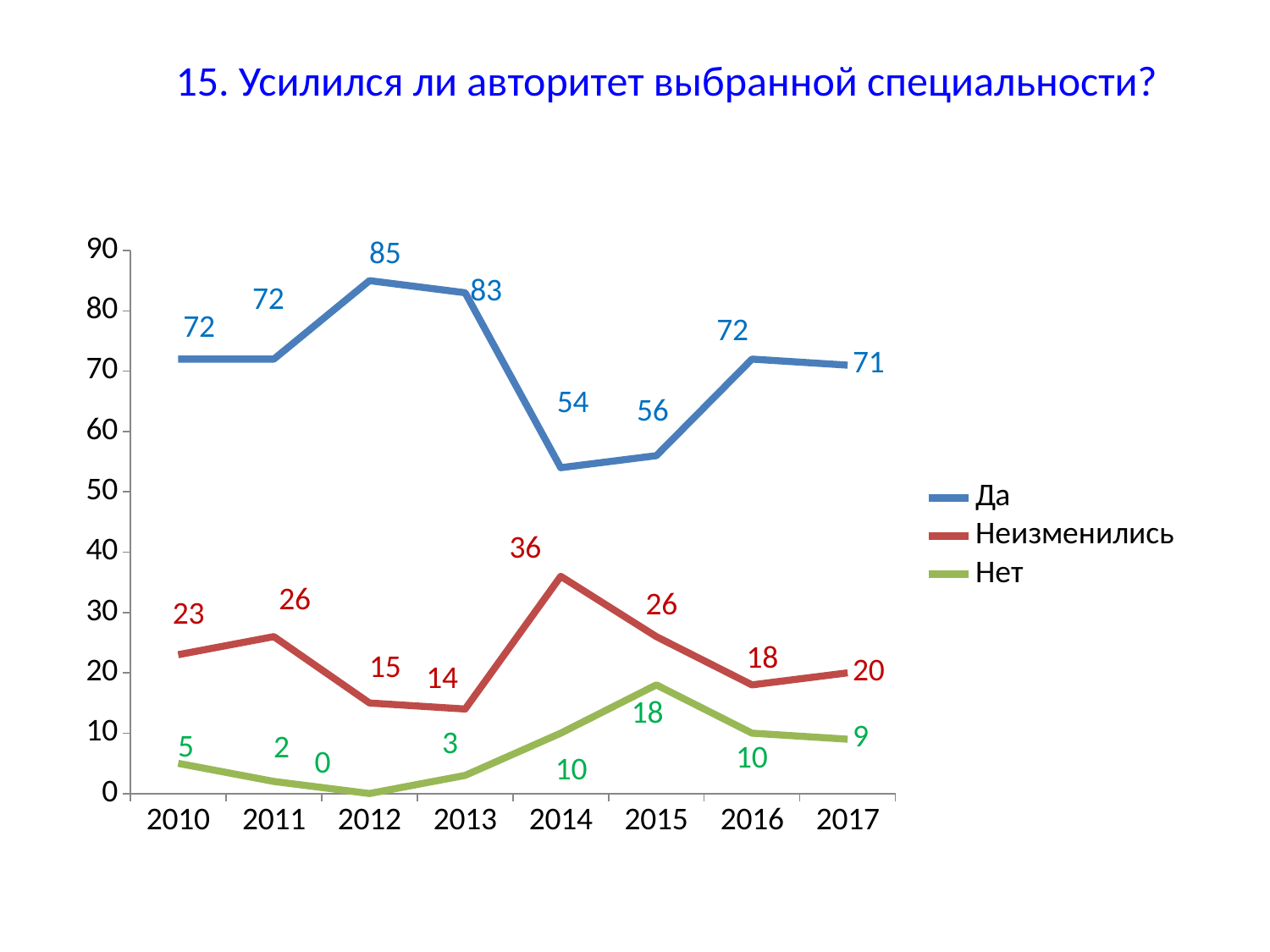
What is the value for "Неизменились" in 2014? 36 What is the value for "Да" in 2012? 85 What is the title of the chart? 15. Усилился ли авторитет выбранной специальности? What is the value for "Нет" in 2015? 18 What kind of chart is shown on the slide? line chart In which year is the "Да" series at its lowest? 2014 How many series does the legend list? 3 What is the difference between the "Да" value in 2012 and the "Да" value in 2014? 31 Does the "Да" series rise or fall from 2013 to 2014? fall How many years are shown on the x axis? 8 Which is larger: the "Неизменились" value in 2011 or in 2012? 2011 In which year is the "Нет" series at its highest? 2015